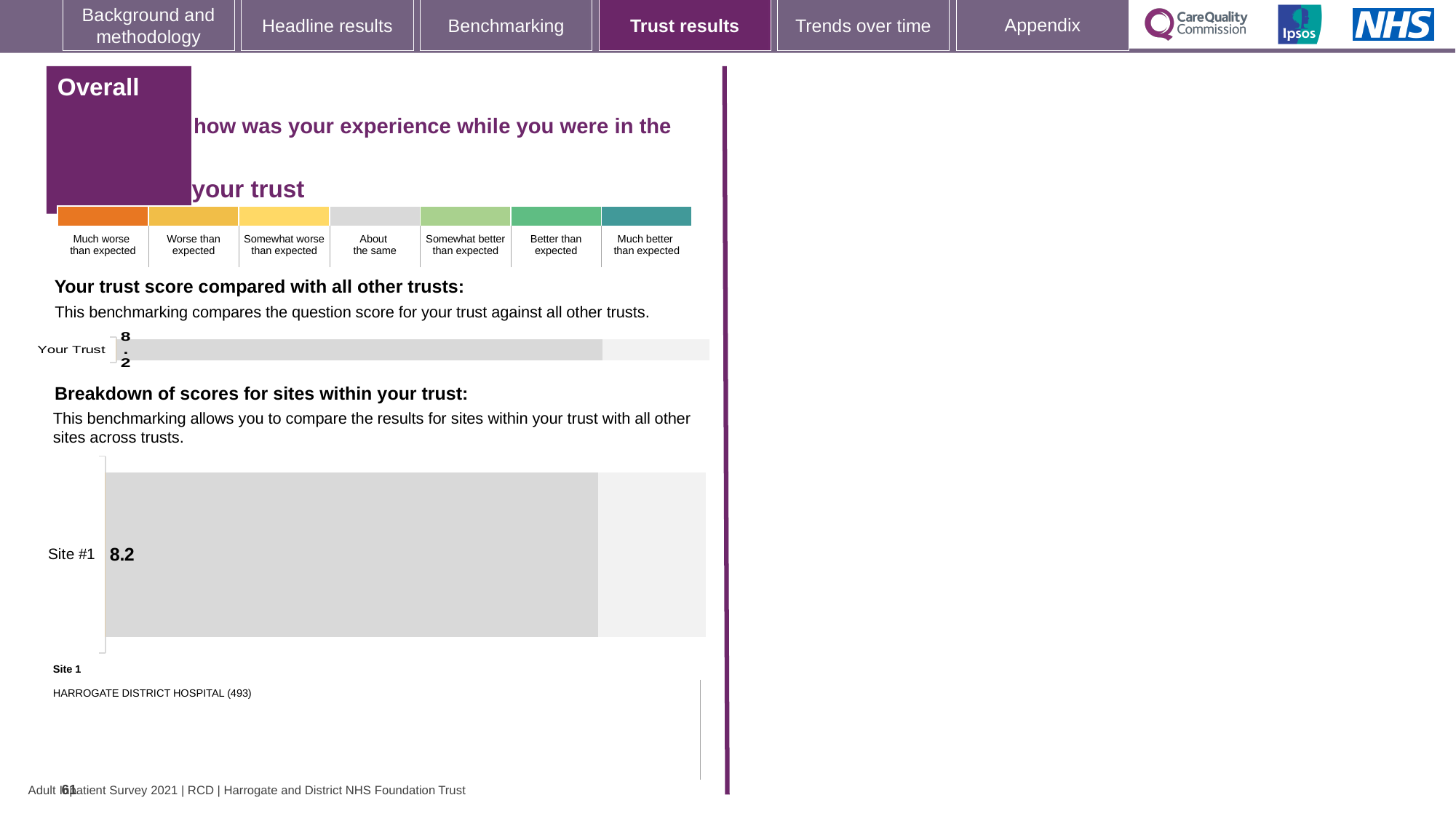
How many rating categories does the colour key above the charts show, from 'Much worse than expected' to 'Much better than expected'? 7 In the 'Your trust score compared with all other trusts' chart, what is the score for Your Trust? 8.2 How many bars are plotted in the 'Your trust score compared with all other trusts' chart? 1 What kind of chart is the 'Breakdown of scores for sites within your trust' chart? bar chart What kind of chart is the 'Your trust score compared with all other trusts' chart? bar chart How many sites are plotted in the 'Breakdown of scores for sites within your trust' chart? 1 In the 'Breakdown of scores for sites within your trust' chart, what is the score for Site #1? 8.2 What is the difference between the Your Trust score in the top chart and the Site #1 score in the bottom chart? 0 In the 'Breakdown of scores for sites within your trust' chart, which hospital is Site 1? HARROGATE DISTRICT HOSPITAL (493)